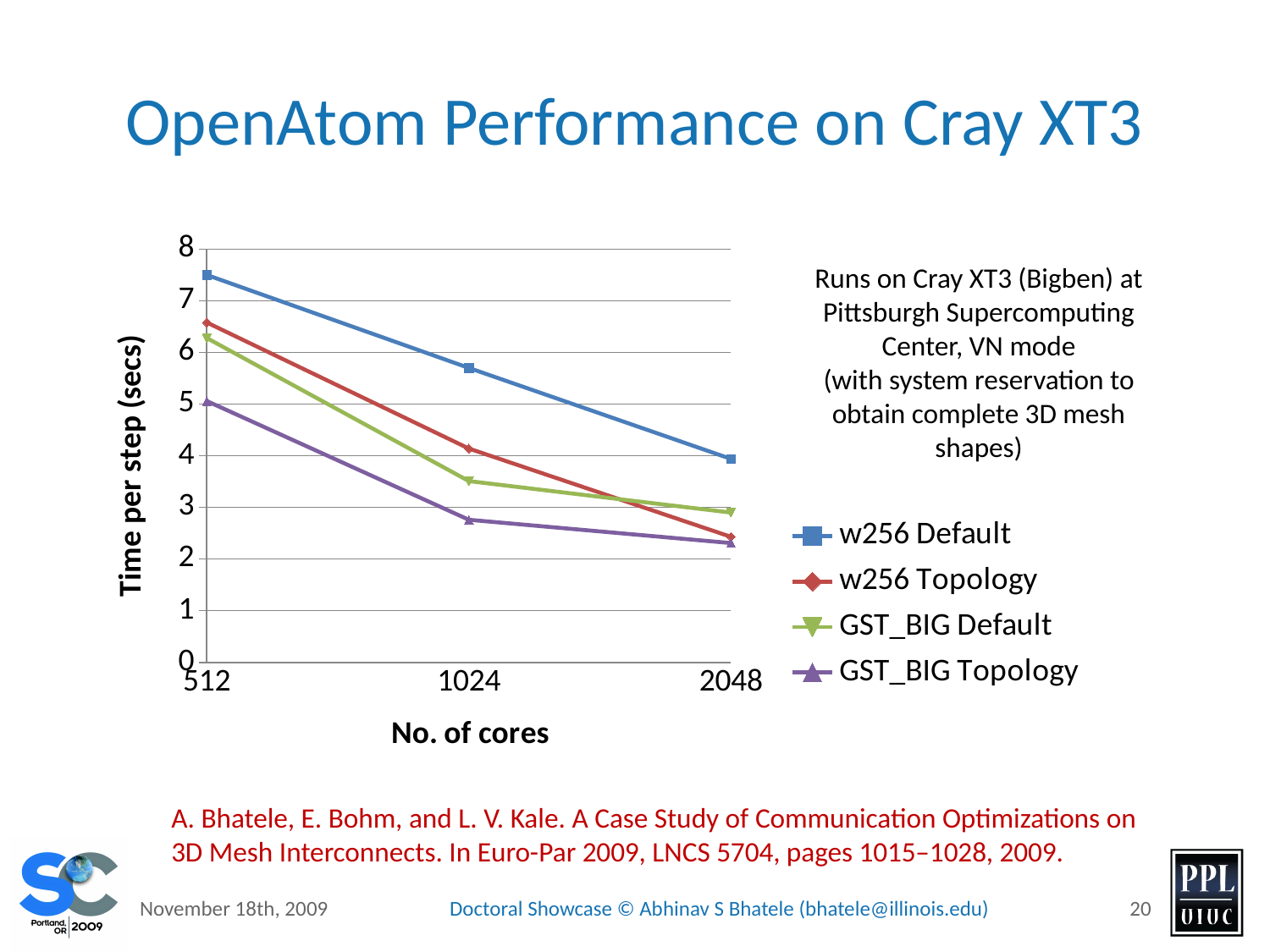
What is the label of the y axis? Time per step (secs) How many series does the legend list? 4 Is the time per step for w256 Topology at 2048 cores greater or less than 3? less What kind of chart is shown on the slide? line chart Is the time per step for w256 Default at 512 cores greater or less than 7? greater Is the time per step for GST_BIG Topology at 1024 cores greater or less than 3? less How many core counts are plotted along the x axis? 3 Does the time per step for w256 Default rise or fall as the number of cores increases? fall Which series has the lowest time per step at 1024 cores? GST_BIG Topology At 2048 cores, which has the larger time per step: GST_BIG Default or w256 Topology? GST_BIG Default Which series has the highest time per step at 512 cores? w256 Default